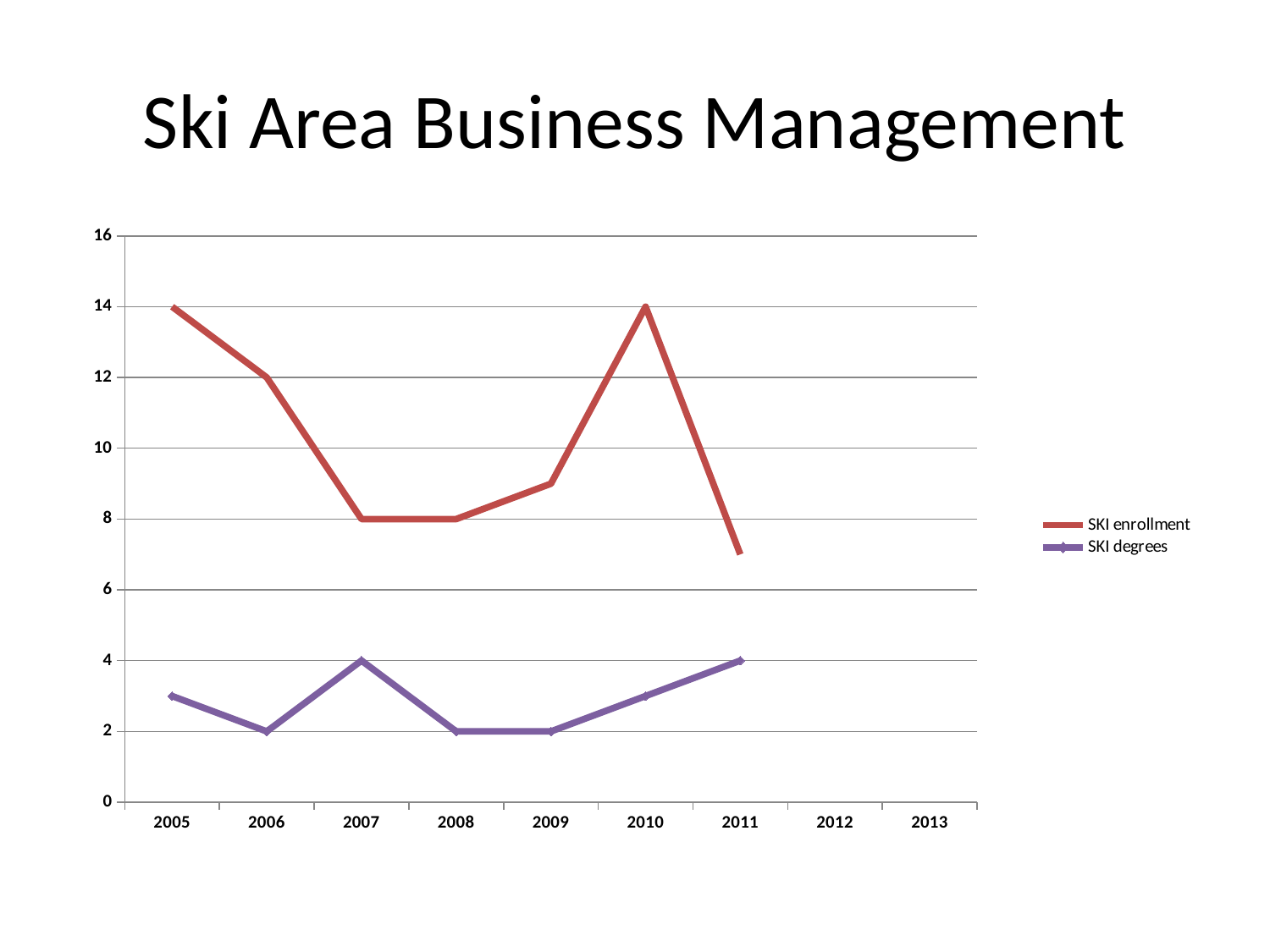
What is the SKI degrees value for 2007? 4 Does SKI enrollment rise or fall from 2005 to 2007? Fall What is the SKI enrollment value for 2007? 8 What is the difference between SKI enrollment in 2005 and in 2007? 6 What is the SKI enrollment value for 2005? 14 How many series does the legend list? 2 In which year is SKI enrollment lowest? 2011 What is the SKI enrollment value for 2006? 12 What type of chart is shown on the slide? Line chart Which year has the higher SKI enrollment, 2006 or 2010? 2010 What is the SKI degrees value for 2008? 2 Is the SKI enrollment value for 2011 greater or less than 8? less